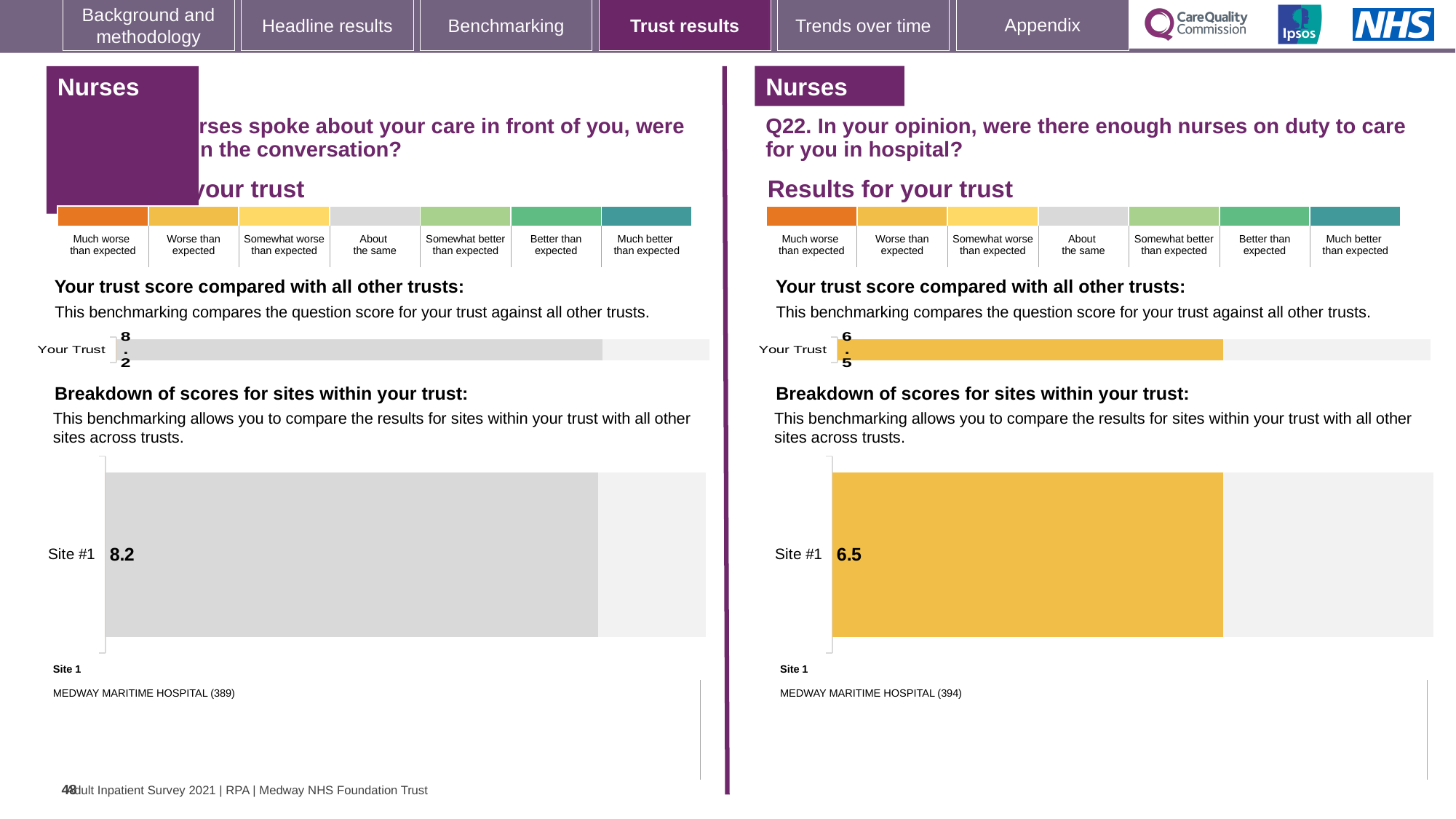
Which hospital is listed as Site 1 beneath the breakdown chart on the right half of the slide (Q22)? MEDWAY MARITIME HOSPITAL (394) How many sites are shown in the 'Breakdown of scores for sites within your trust' chart on the right half of the slide (Q22)? 1 According to the colour key, which benchmark category does the grey colour of the Site #1 bar on the left half of the slide correspond to? About the same On the left half of the slide, what is the score shown for Your Trust in the 'Your trust score compared with all other trusts' chart? 8.2 In the 'Breakdown of scores for sites within your trust' chart on the right half of the slide (Q22), what is the score for Site #1? 6.5 What type of chart is used to show the Site #1 score in the breakdown charts on this slide? Bar chart In the 'Breakdown of scores for sites within your trust' chart on the left half of the slide, what is the score for Site #1? 8.2 What is the difference between the Site #1 score on the left half of the slide and the Site #1 score on the right half (Q22)? 1.7 How many sites are shown in the 'Breakdown of scores for sites within your trust' chart on the left half of the slide? 1 Which is larger: the Site #1 score in the left-hand breakdown chart or the Site #1 score in the right-hand (Q22) breakdown chart? The left-hand chart (8.2) According to the colour key, which benchmark category does the yellow colour of the Q22 Site #1 bar on the right half of the slide correspond to? Worse than expected On the right half of the slide (Q22), what is the score shown for Your Trust in the 'Your trust score compared with all other trusts' chart? 6.5